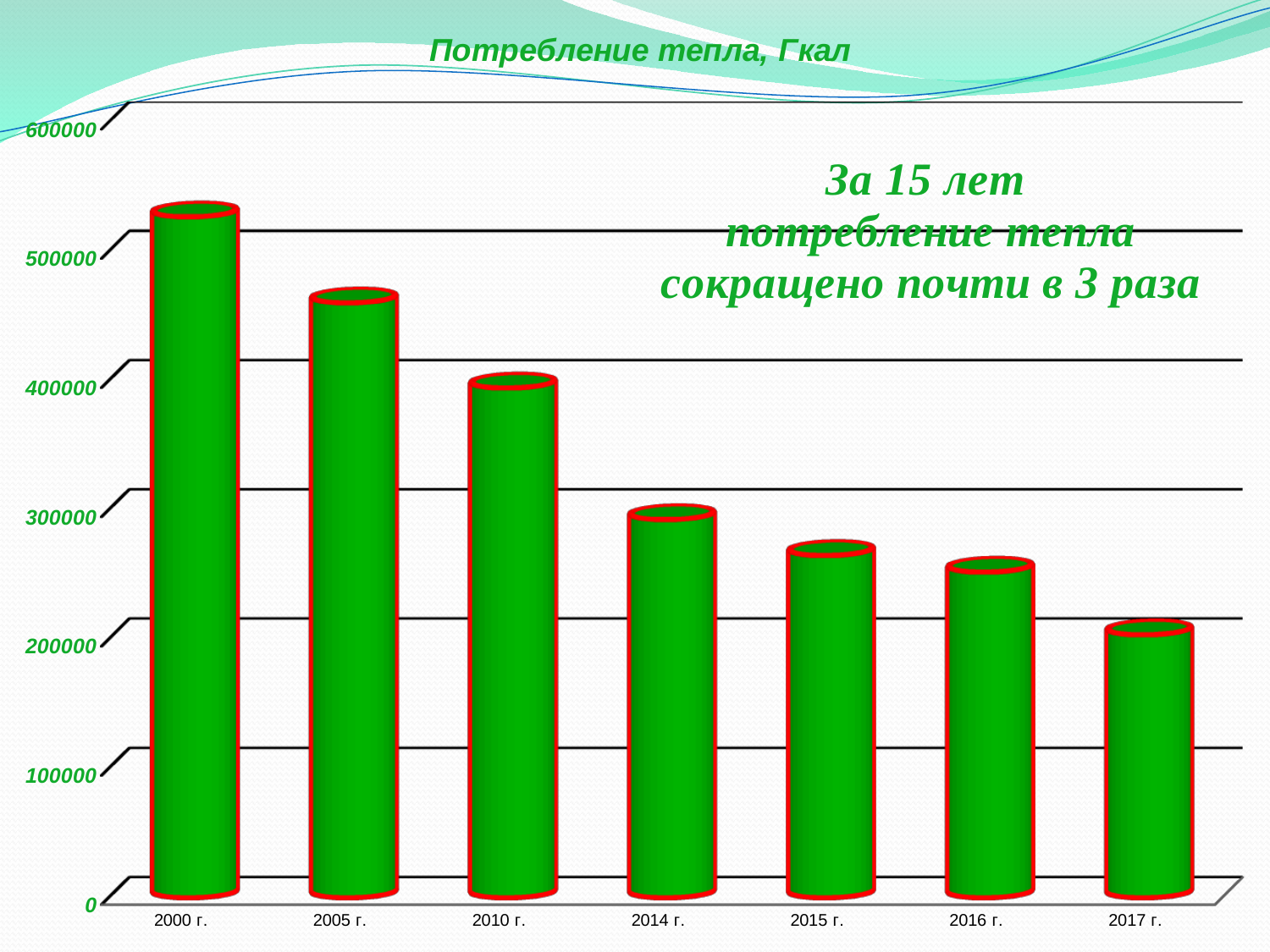
Which year has the lowest heat consumption? 2017 г. Is the value for 2015 г. greater or less than 300000? less Do the values rise or fall from 2000 г. to 2017 г.? fall Is the value for 2005 г. greater or less than 500000? less What is the title of the chart? Потребление тепла, Гкал How many years (categories) are shown on the x axis? 7 Which is larger, the value for 2005 г. or the value for 2014 г.? 2005 г. Is the value for 2016 г. greater or less than 200000? greater What kind of chart is shown on the slide? bar chart According to the text on the chart, by roughly how many times was heat consumption reduced over 15 years? почти в 3 раза Which year has the highest heat consumption? 2000 г.